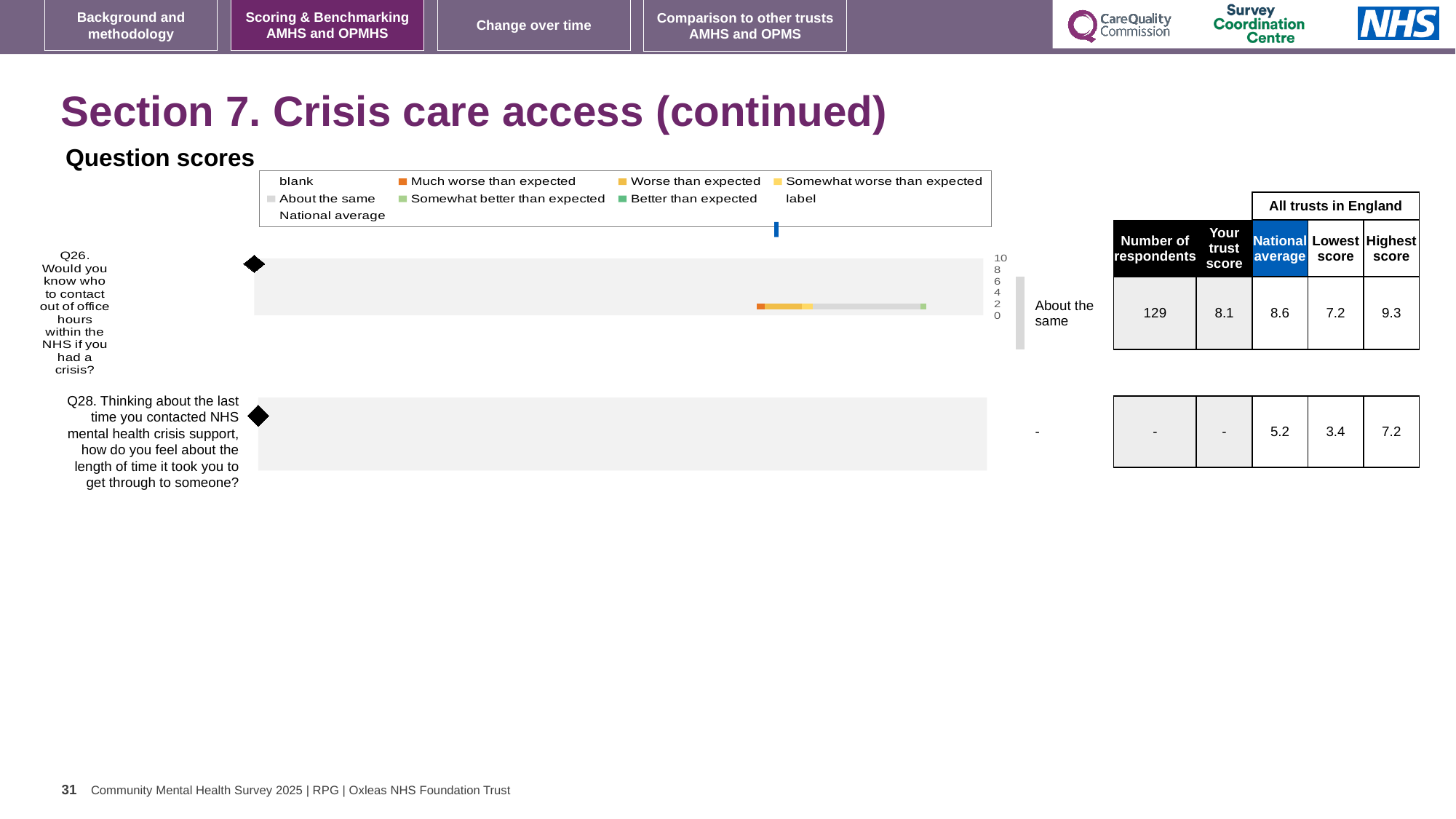
What is the national average score for Q26? 8.6 What is the trust's score for Q26 (knowing who to contact out of office hours in a crisis)? 8.1 What is the difference between the highest and lowest trust scores for Q26? 2.1 How many respondents answered Q26? 129 What kind of chart is used to show the question scores on this slide? bar chart What benchmark category is shown for Q26? About the same How many questions are plotted in the question scores chart? 2 What colour does the legend use for 'Much worse than expected'? orange What is the national average score for Q28 (length of time to get through to crisis support)? 5.2 What is the lowest score among all trusts in England for Q28? 3.4 For Q26, which is larger: the trust's score or the national average? the national average What is the highest score among all trusts in England for Q26? 9.3